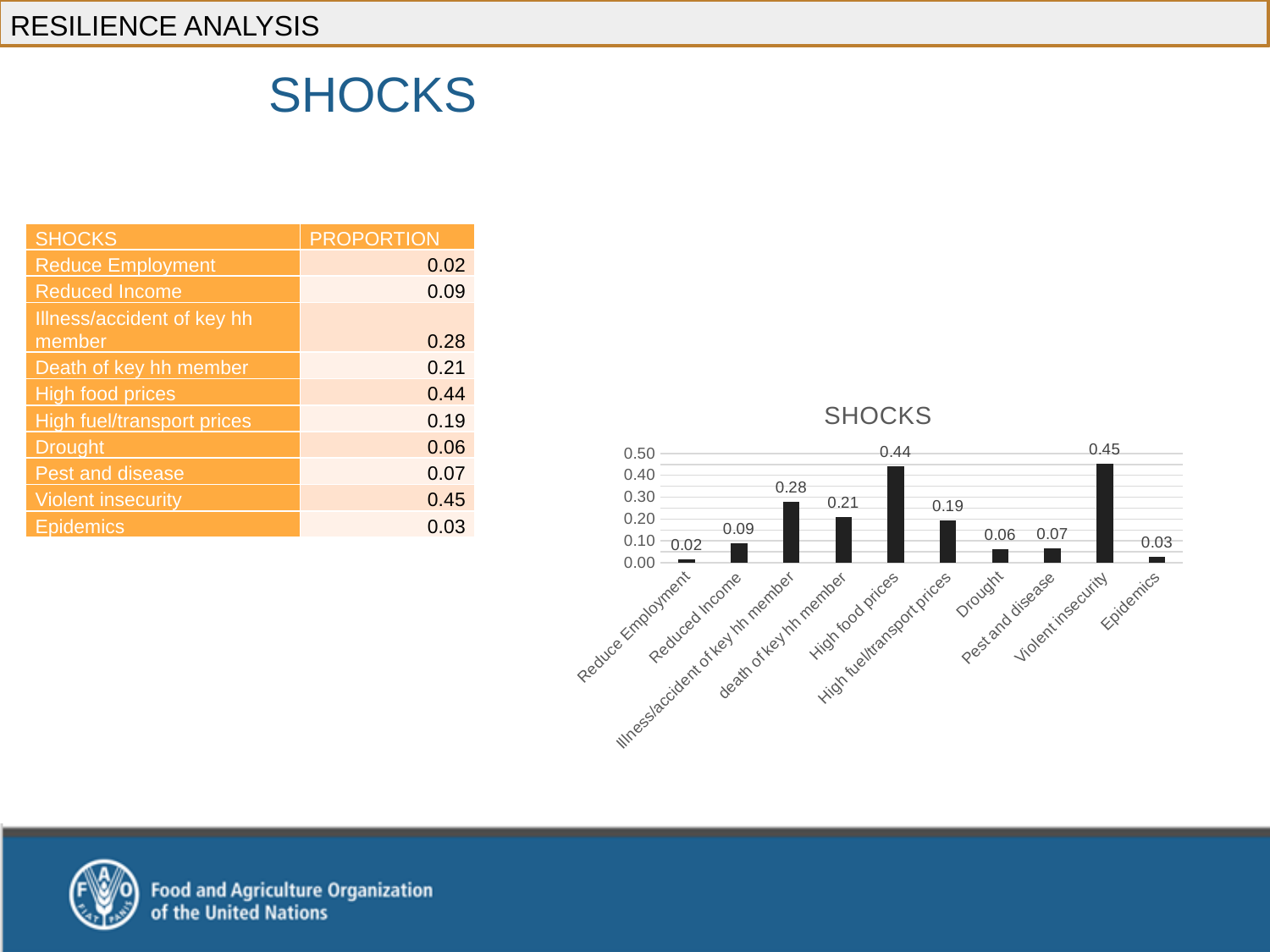
Which category has the lowest value in the SHOCKS chart? Reduce Employment What is the difference between the values for High food prices and High fuel/transport prices in the SHOCKS chart? 0.25 What is the title of the chart on the slide? SHOCKS How many categories are shown in the SHOCKS chart? 10 What is the difference between the values for Violent insecurity and Epidemics in the SHOCKS chart? 0.42 What is the value for High food prices in the SHOCKS chart? 0.44 Is the value for death of key hh member in the SHOCKS chart greater or less than 0.30? less Which is larger in the SHOCKS chart, the value for Reduced Income or the value for Pest and disease? Reduced Income What is the value for Illness/accident of key hh member in the SHOCKS chart? 0.28 Which category has the highest value in the SHOCKS chart? Violent insecurity What is the value for Drought in the SHOCKS chart? 0.06 What kind of chart is the SHOCKS chart? Bar chart